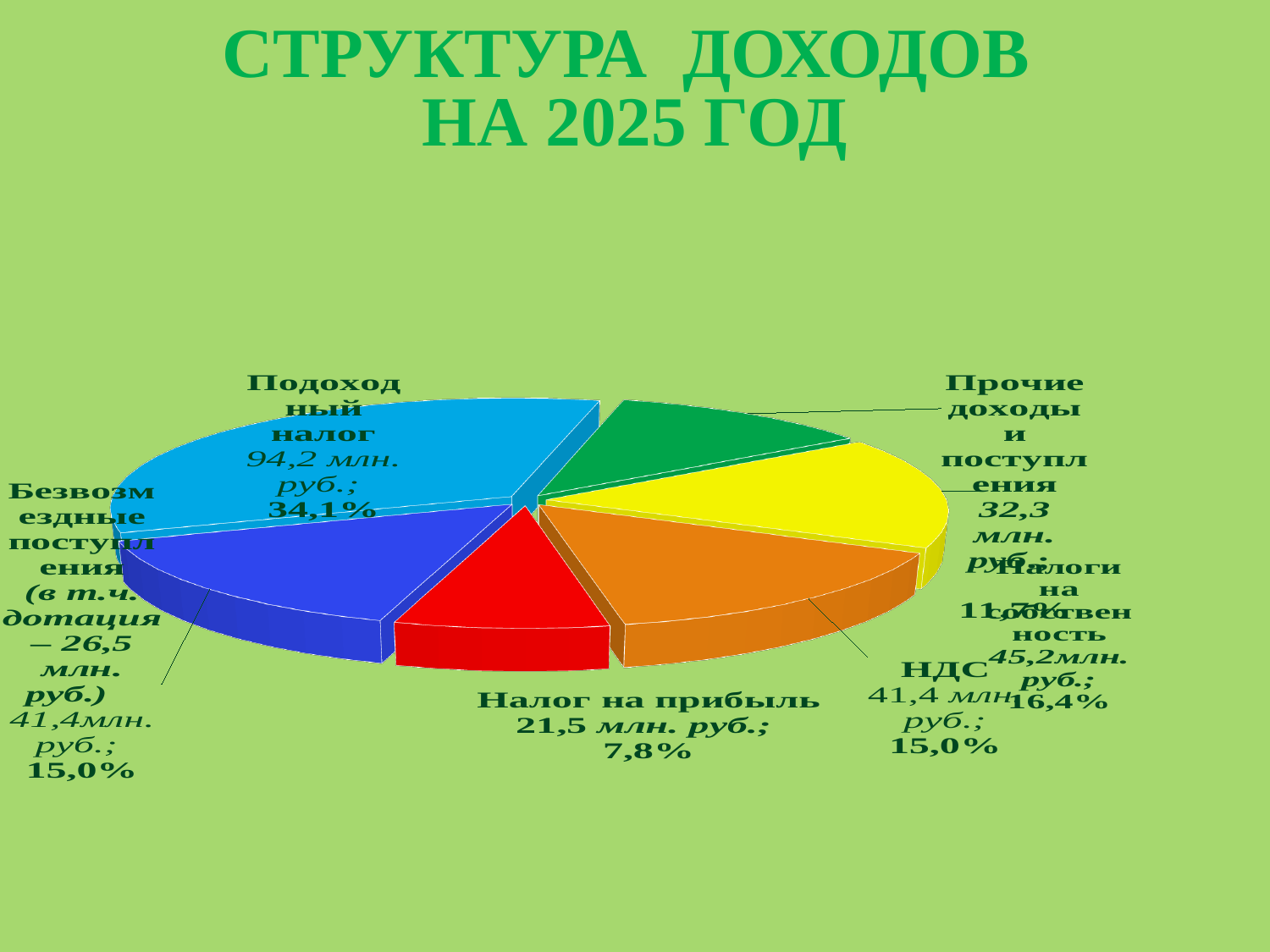
Which slice of the pie chart is the smallest? Налог на прибыль How many slices does the pie chart have? 6 What percentage share does Налог на прибыль have? 7,8% What is the difference in percentage points between Подоходный налог (34,1%) and Налоги на собственность (16,4%)? 17,7% What is the amount shown for Налоги на собственность? 45,2 млн. руб. Which slice of the pie chart is the largest? Подоходный налог What is the title of the slide's chart? СТРУКТУРА ДОХОДОВ НА 2025 ГОД Which is larger, Налоги на собственность or НДС? Налоги на собственность What is the amount shown for НДС? 41,4 млн. руб. What kind of chart is shown on the slide? pie chart What is the amount shown for Подоходный налог? 94,2 млн. руб. What percentage share does Подоходный налог have in the pie chart? 34,1%